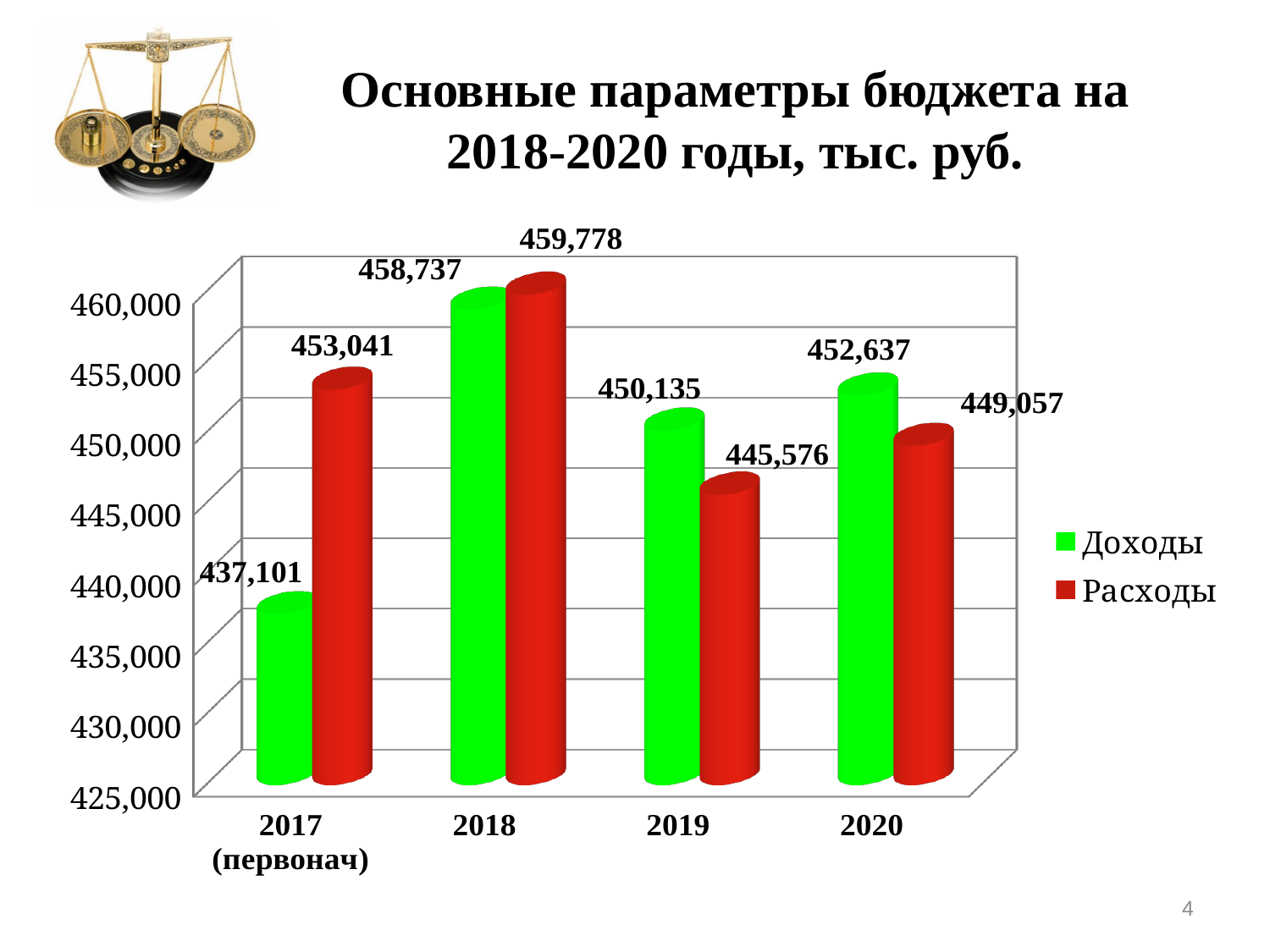
Which is larger in 2020, Доходы or Расходы? Доходы How many years are shown on the x axis? 4 In which year is Расходы highest? 2018 What is the value of Доходы for 2017 (первонач)? 437,101 How many series does the legend list? 2 Is the value of Расходы for 2018 greater or less than 455,000? greater In which year is Доходы lowest? 2017 (первонач) What kind of chart is shown on the slide? Bar chart What is the value of Расходы for 2019? 445,576 What is the difference between Доходы and Расходы in 2019? 4,559 What is the value of Доходы for 2020? 452,637 What is the difference between Расходы and Доходы in 2017 (первонач)? 15,940